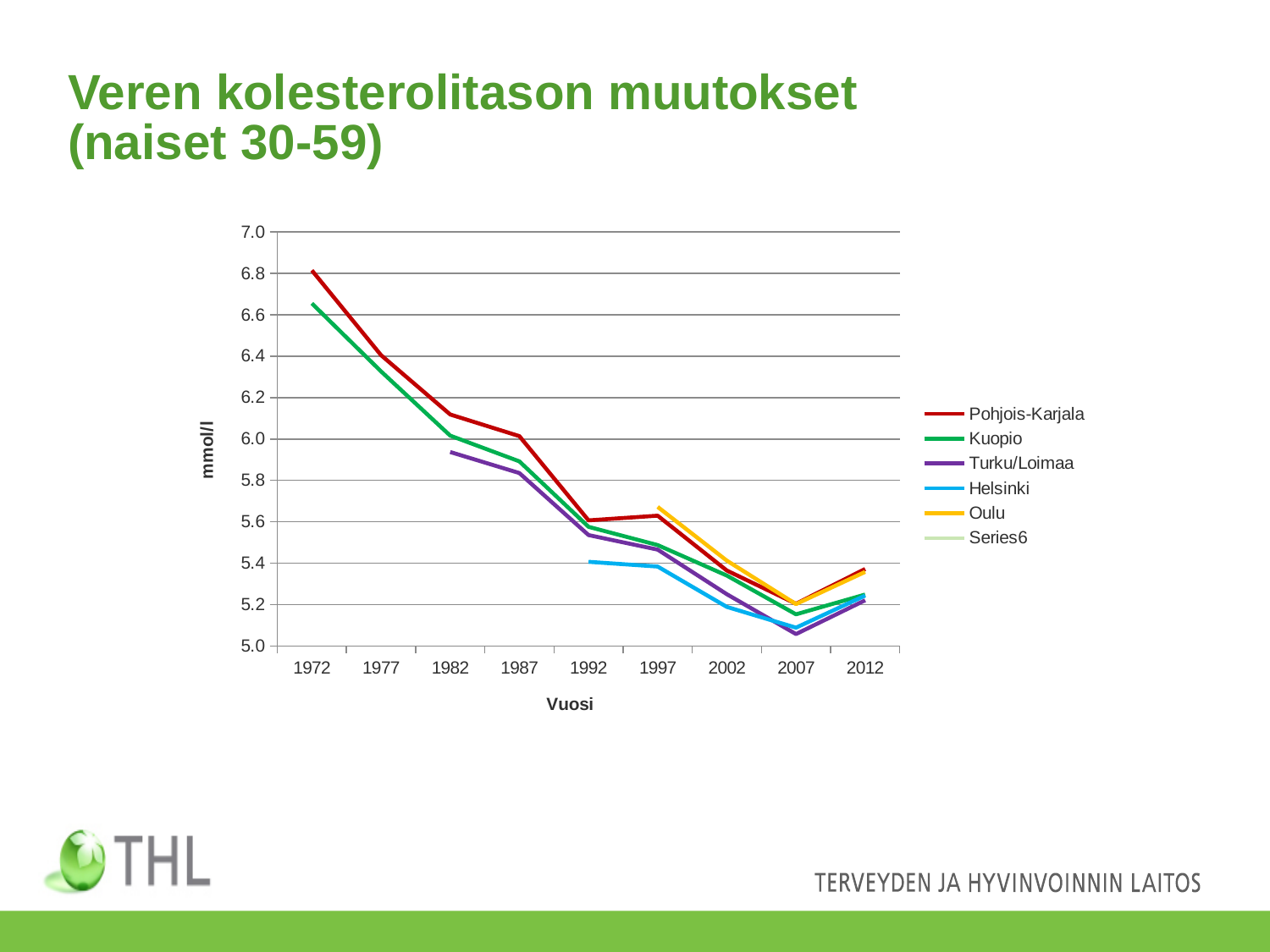
In which year does the Pohjois-Karjala series reach its lowest value? 2007 Is the value for Pohjois-Karjala in 1972 greater or less than 6.6? greater How many years are marked on the x axis? 9 What kind of chart is shown on the slide? line chart How many series does the legend list? 6 Is the value for Turku/Loimaa in 2007 greater or less than 5.2? less Which series has the higher value in 1972, Pohjois-Karjala or Kuopio? Pohjois-Karjala Is the value for Kuopio in 1972 greater or less than 6.4? greater Which series has the higher value in 1997, Pohjois-Karjala or Helsinki? Pohjois-Karjala Do the cholesterol values generally rise or fall from 1972 to 2007? fall What unit is shown on the y axis label? mmol/l